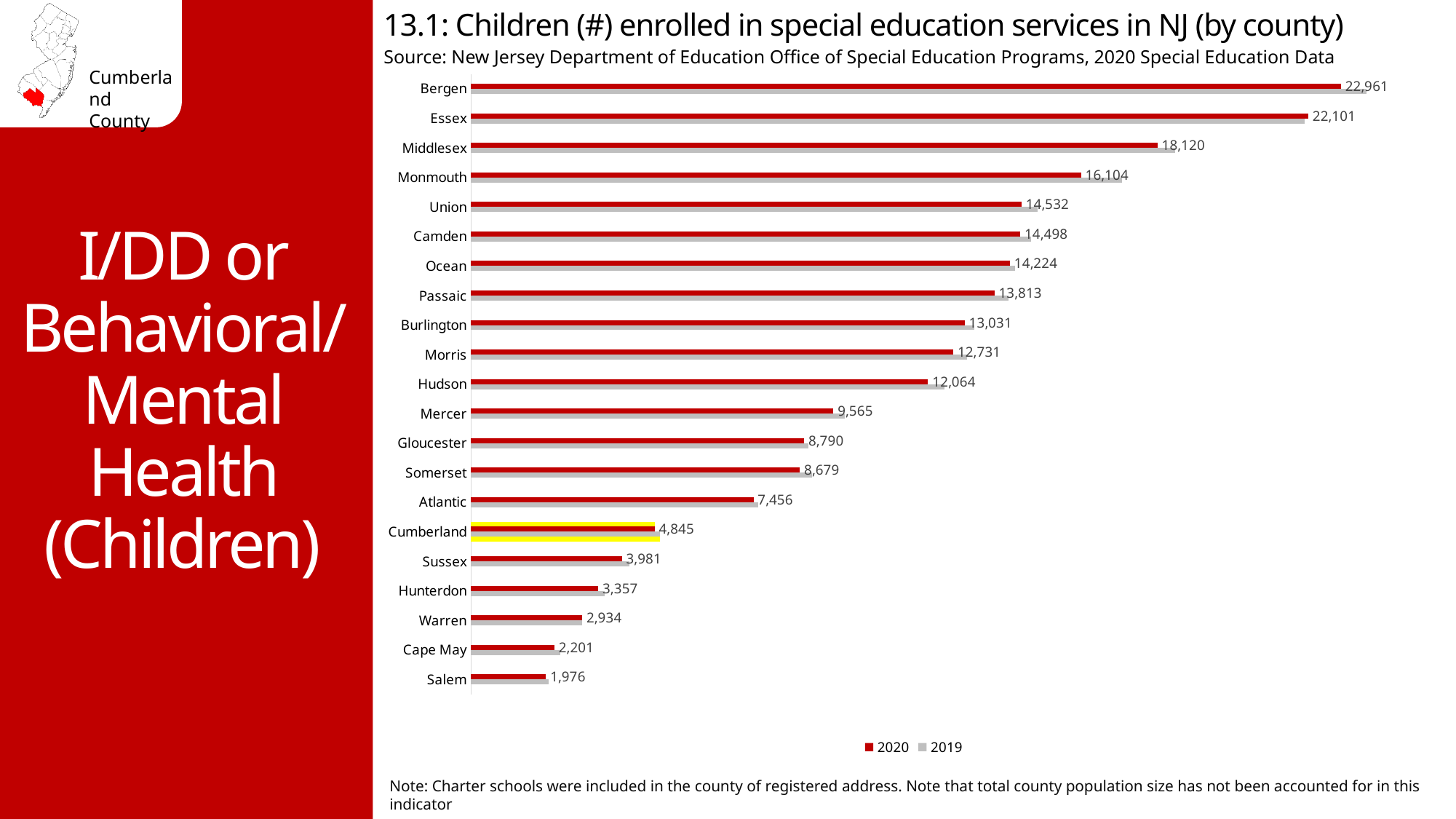
Which county has the highest 2020 value? Bergen What is the difference between the 2020 values for Cumberland and Salem? 2,869 What is the difference between the 2020 values for Bergen and Essex? 860 What type of chart is shown on the slide? Bar chart Which has a larger 2020 value, Gloucester or Atlantic? Gloucester How many counties are shown in the chart? 21 What is the 2020 value for Camden? 14,498 Which county's bars are highlighted in yellow on the chart? Cumberland What is the 2020 value for Cumberland? 4,845 Which county has the lowest 2020 value? Salem How many series does the legend list? 2 What is the 2020 value for Cape May? 2,201